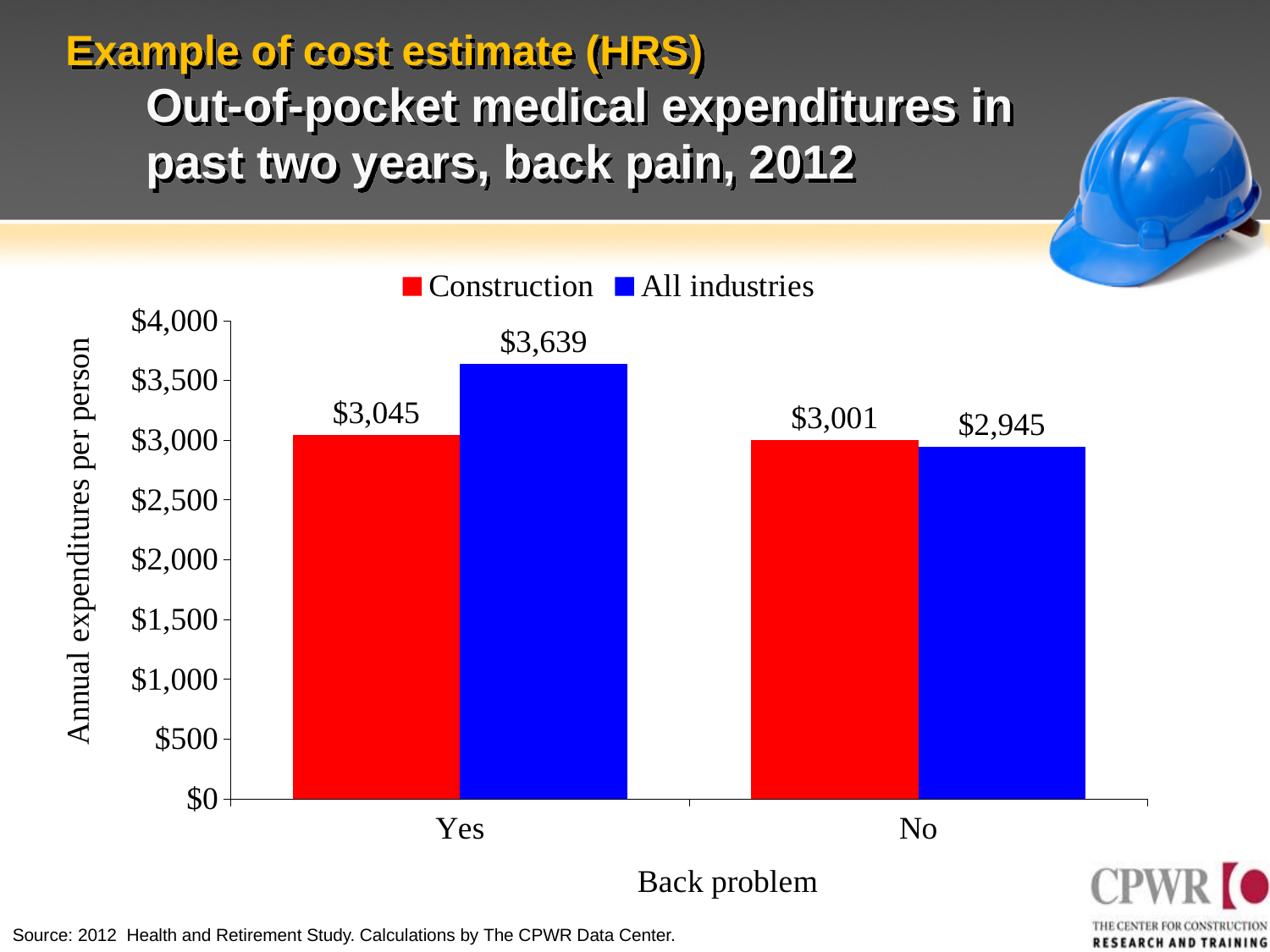
What is the value for All industries in the No category? $2,945 Which bar has the lowest value on the chart? All industries, No What is the label of the y axis? Annual expenditures per person What is the value for All industries in the Yes category? $3,639 How many series does the legend list? 2 Which bar has the highest value on the chart? All industries, Yes What is the difference between All industries and Construction in the Yes category? $594 What kind of chart is shown on the slide? Bar chart In the Yes category, which is larger: Construction or All industries? All industries What is the value for Construction in the No category? $3,001 What is the difference between Construction and All industries in the No category? $56 What is the value for Construction in the Yes category? $3,045